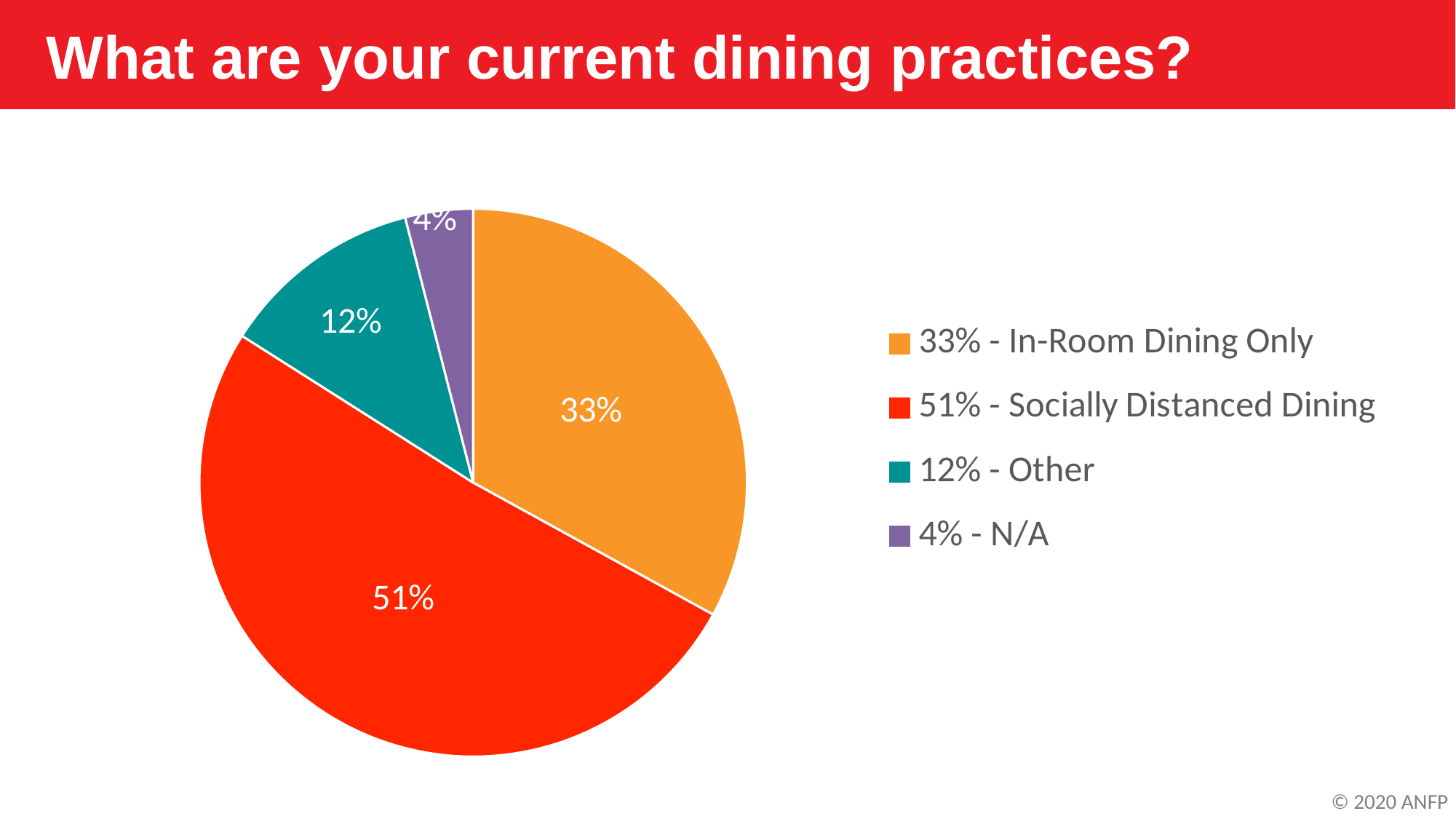
What share of the pie is N/A? 4% Which category has the smallest slice of the pie? N/A Which category has the largest slice of the pie? Socially Distanced Dining How many slices does the pie chart have? 4 Which is larger, the share for Other or the share for N/A? Other What share of the pie is Socially Distanced Dining? 51% What is the difference in percentage points between Socially Distanced Dining and In-Room Dining Only? 18 What colour is the slice for Other? teal What is the title of the slide? What are your current dining practices? What share of the pie is In-Room Dining Only? 33% What kind of chart is shown on the slide? pie chart